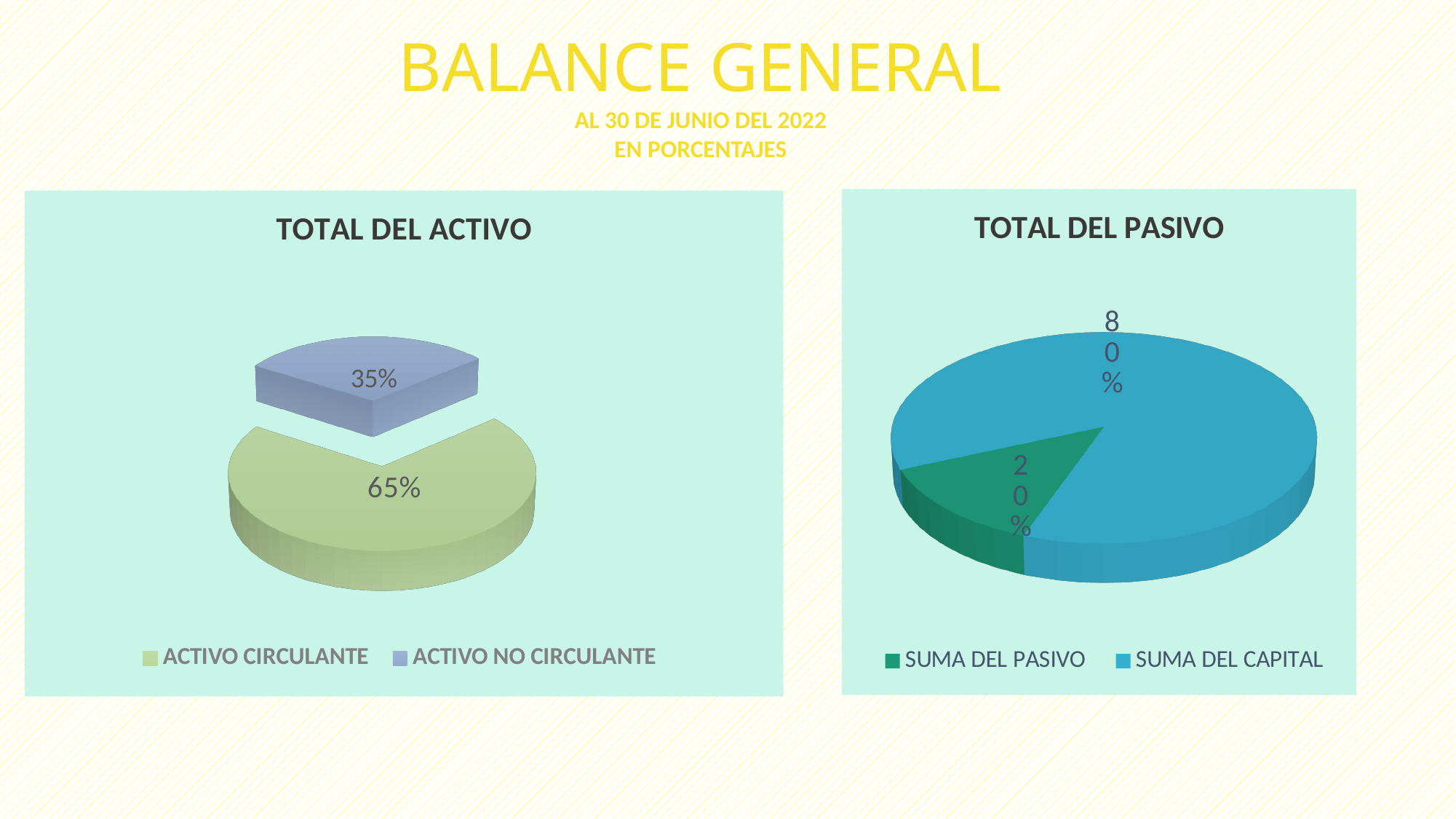
In the 'TOTAL DEL PASIVO' chart, what percentage is shown for SUMA DEL PASIVO? 20% How many slices does the 'TOTAL DEL PASIVO' chart have? 2 In the 'TOTAL DEL PASIVO' chart, what percentage is shown for SUMA DEL CAPITAL? 80% In the 'TOTAL DEL PASIVO' chart, which is larger, SUMA DEL PASIVO or SUMA DEL CAPITAL? SUMA DEL CAPITAL In the 'TOTAL DEL ACTIVO' chart, which category has the largest slice? ACTIVO CIRCULANTE In the 'TOTAL DEL ACTIVO' chart, what percentage is shown for ACTIVO NO CIRCULANTE? 35% In the 'TOTAL DEL PASIVO' chart, which category has the smallest slice? SUMA DEL PASIVO In the 'TOTAL DEL ACTIVO' chart, what percentage is shown for ACTIVO CIRCULANTE? 65% In the 'TOTAL DEL PASIVO' chart, what is the difference in percentage points between SUMA DEL CAPITAL and SUMA DEL PASIVO? 60 What kind of chart is the 'TOTAL DEL ACTIVO' chart? Pie chart In the 'TOTAL DEL ACTIVO' chart, what is the difference in percentage points between ACTIVO CIRCULANTE and ACTIVO NO CIRCULANTE? 30 How many entries does the legend of the 'TOTAL DEL ACTIVO' chart list? 2